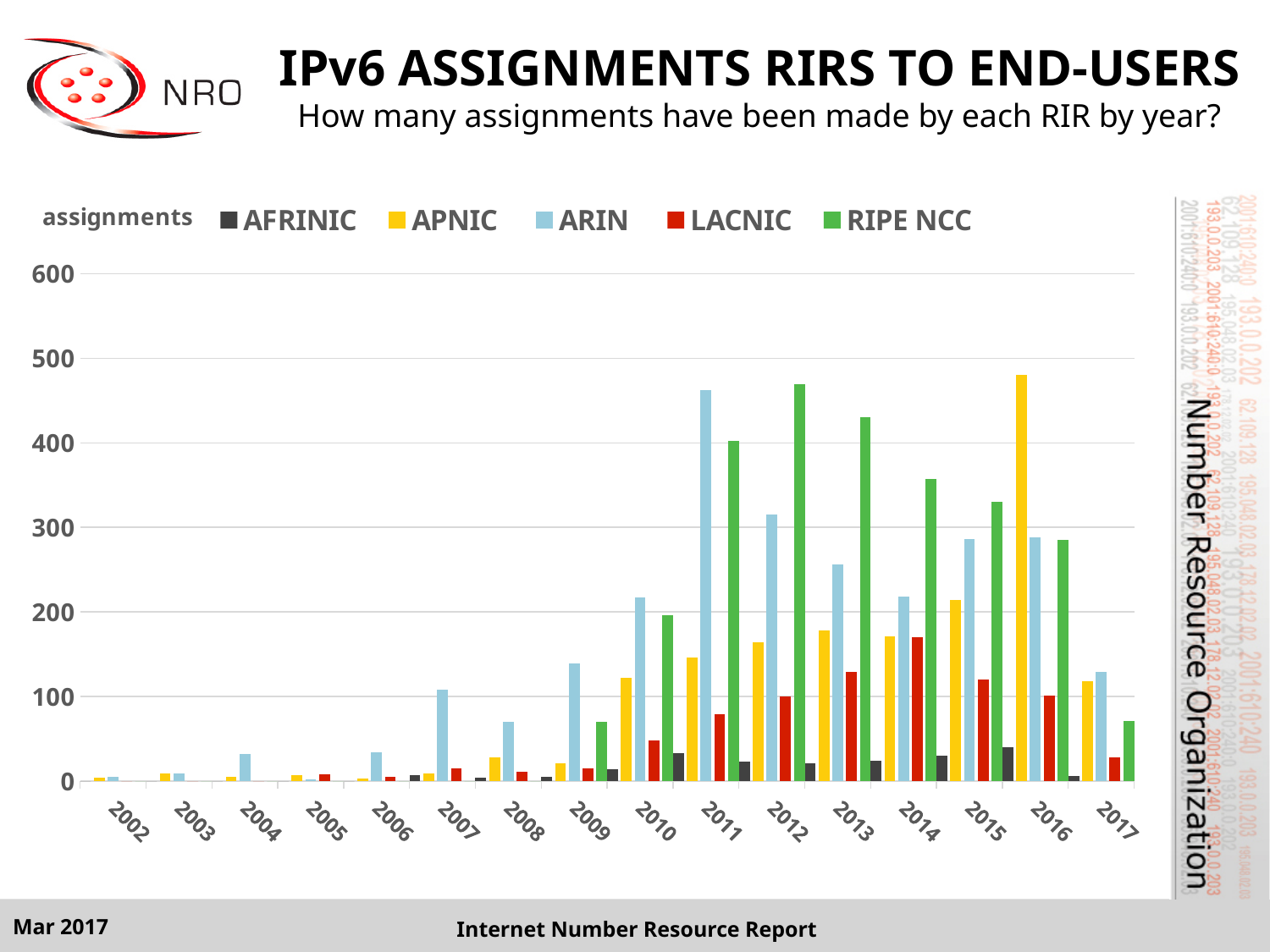
Is the value for AFRINIC in 2015 greater or less than 100? less In 2011, which is larger: ARIN or RIPE NCC? ARIN Is the value for ARIN in 2011 greater or less than 400? greater What kind of chart is shown on the slide? bar chart Which RIR has the lowest value in 2016? AFRINIC How many series does the legend list? 5 How many years are shown along the x axis? 16 Is the value for RIPE NCC in 2012 greater or less than 400? greater In 2013, which is larger: RIPE NCC or ARIN? RIPE NCC Which RIR has the highest value in 2014? RIPE NCC